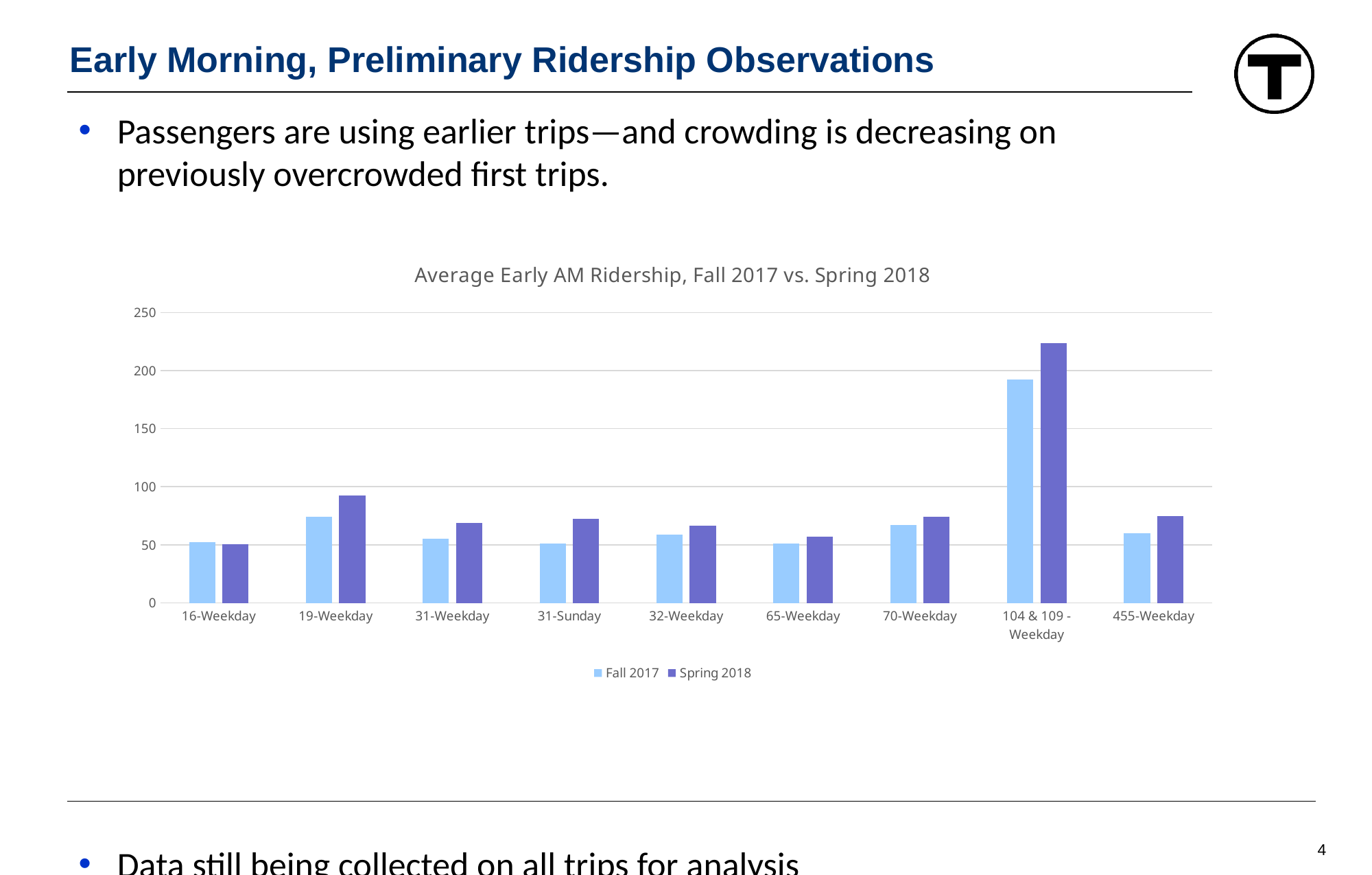
Which category has the lowest Spring 2018 value? 16-Weekday How many route categories are shown on the x axis? 9 Which category has the highest Fall 2017 value? 104 & 109 - Weekday Is the Fall 2017 value for 104 & 109 - Weekday greater or less than 150? greater What is the title of the chart? Average Early AM Ridership, Fall 2017 vs. Spring 2018 How many series does the legend list? 2 Is the Spring 2018 value for 19-Weekday greater or less than 100? less Which category has the highest Spring 2018 value? 104 & 109 - Weekday For 455-Weekday, which is larger: the Fall 2017 value or the Spring 2018 value? Spring 2018 Is the Spring 2018 value for 104 & 109 - Weekday greater or less than 200? greater For 31-Sunday, which is larger: the Fall 2017 value or the Spring 2018 value? Spring 2018 What kind of chart is shown on the slide? bar chart